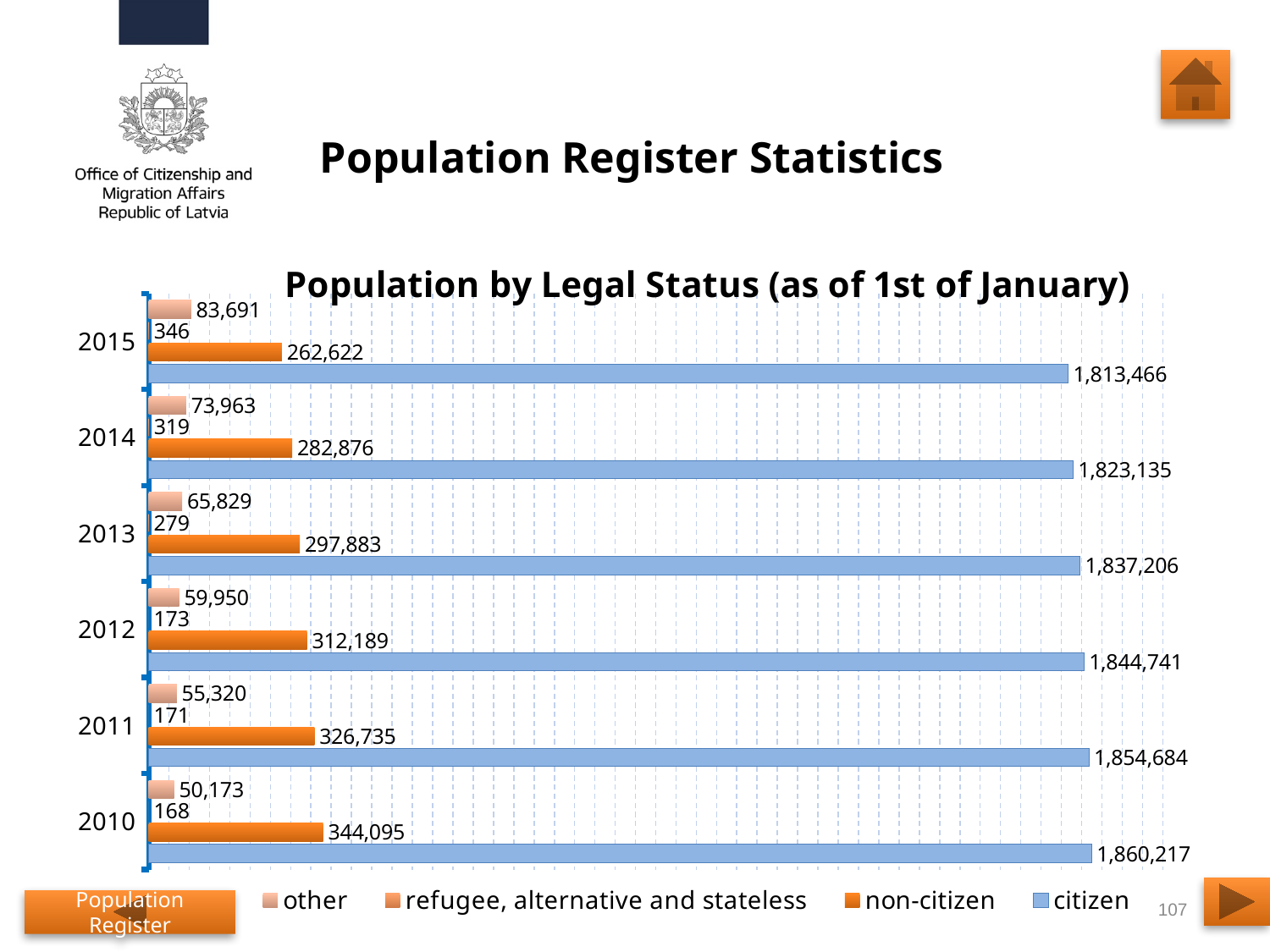
What is the value for 'refugee, alternative and stateless' in 2013? 279 In which year is the number of citizens highest? 2010 What is the number of non-citizens in 2010? 344,095 In which year is the number of non-citizens lowest? 2015 What is the difference between the number of citizens in 2010 and in 2015? 46,751 Which is larger: the 'other' value in 2014 or in 2011? 2014 What is the number of citizens in 2015? 1,813,466 How many years are shown on the chart? 6 What is the value for 'other' in 2012? 59,950 By how much did the number of non-citizens fall from 2010 to 2015? 81,473 What kind of chart is this? Bar chart How many series does the legend list? 4